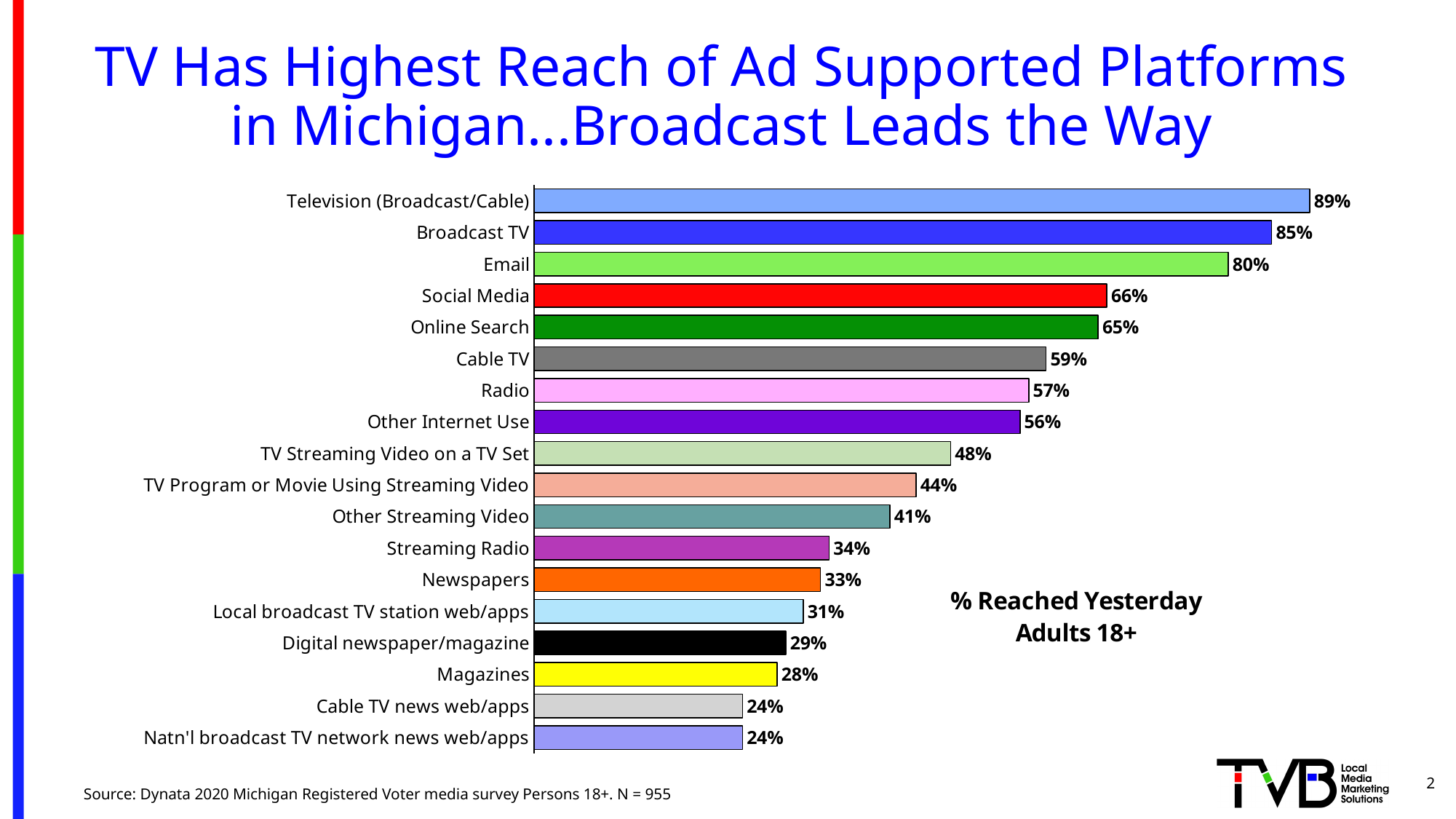
What is the value for Radio? 57% What is the difference between the values for Cable TV and Streaming Radio? 25% What is the value for TV Streaming Video on a TV Set? 48% Which category has the highest value? Television (Broadcast/Cable) Which is larger, the value for Magazines or the value for Local broadcast TV station web/apps? Local broadcast TV station web/apps How many categories are shown in the chart? 18 What is the value for Broadcast TV? 85% What text label appears inside the chart area to the right of the bars? % Reached Yesterday Adults 18+ Which is larger, the value for Online Search or the value for Other Internet Use? Online Search What is the difference between the values for Email and Social Media? 14% What kind of chart is shown on the slide? Bar chart What is the value for Newspapers? 33%